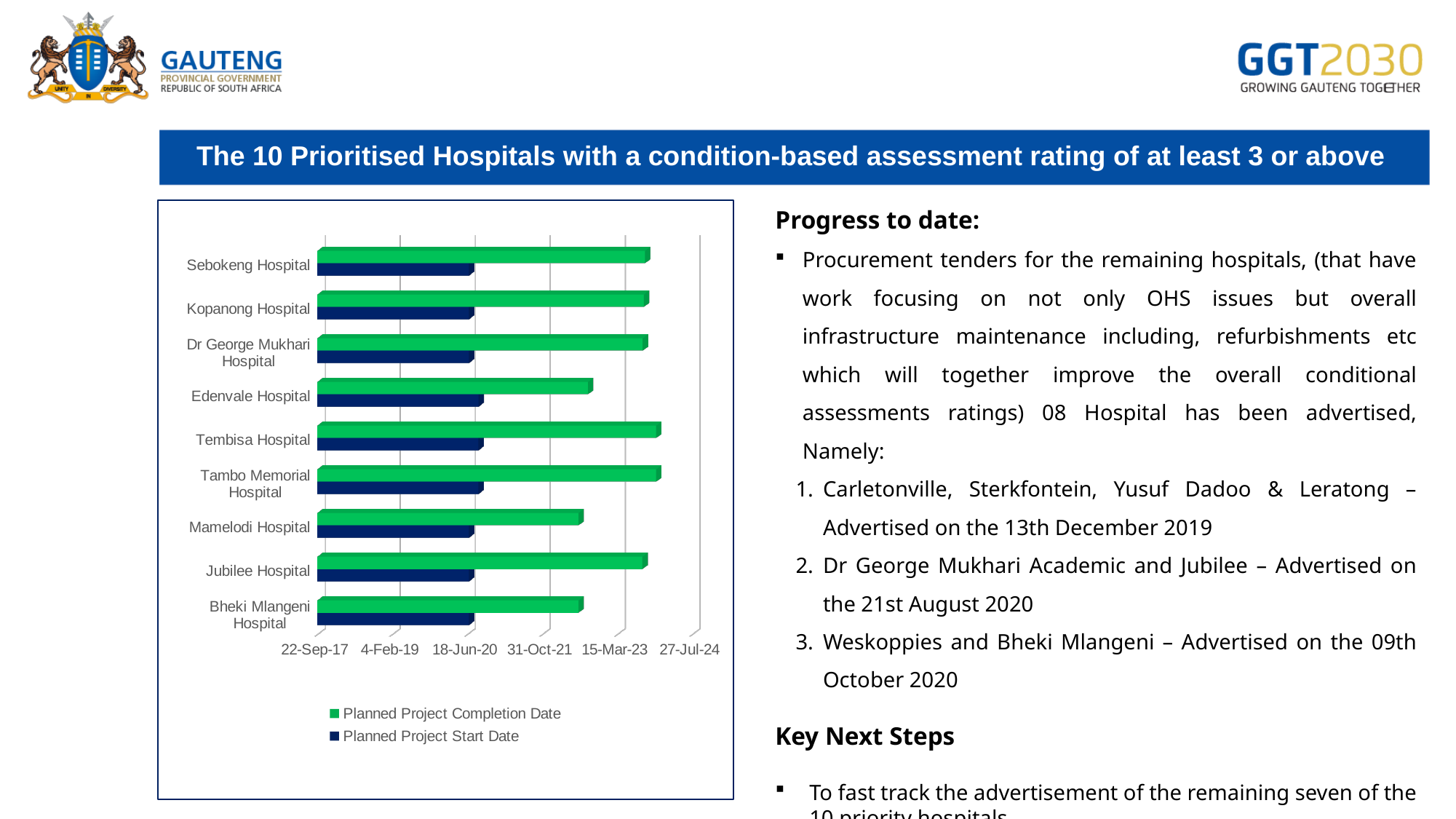
Which has the later Planned Project Completion Date, Tambo Memorial Hospital or Edenvale Hospital? Tambo Memorial Hospital Which has the later Planned Project Completion Date, Tembisa Hospital or Mamelodi Hospital? Tembisa Hospital Which series is shown in dark blue on the chart? Planned Project Start Date How many series does the chart legend list? 2 Is the Planned Project Start Date for Sebokeng Hospital earlier or later than 31-Oct-21? earlier Is the Planned Project Start Date for Jubilee Hospital earlier or later than 4-Feb-19? later Is the Planned Project Completion Date for Mamelodi Hospital earlier or later than 15-Mar-23? earlier Which series is shown in green on the chart? Planned Project Completion Date How many hospitals are listed as categories on the chart? 9 What kind of chart is shown on the slide? Bar chart Which has the later Planned Project Completion Date, Jubilee Hospital or Bheki Mlangeni Hospital? Jubilee Hospital